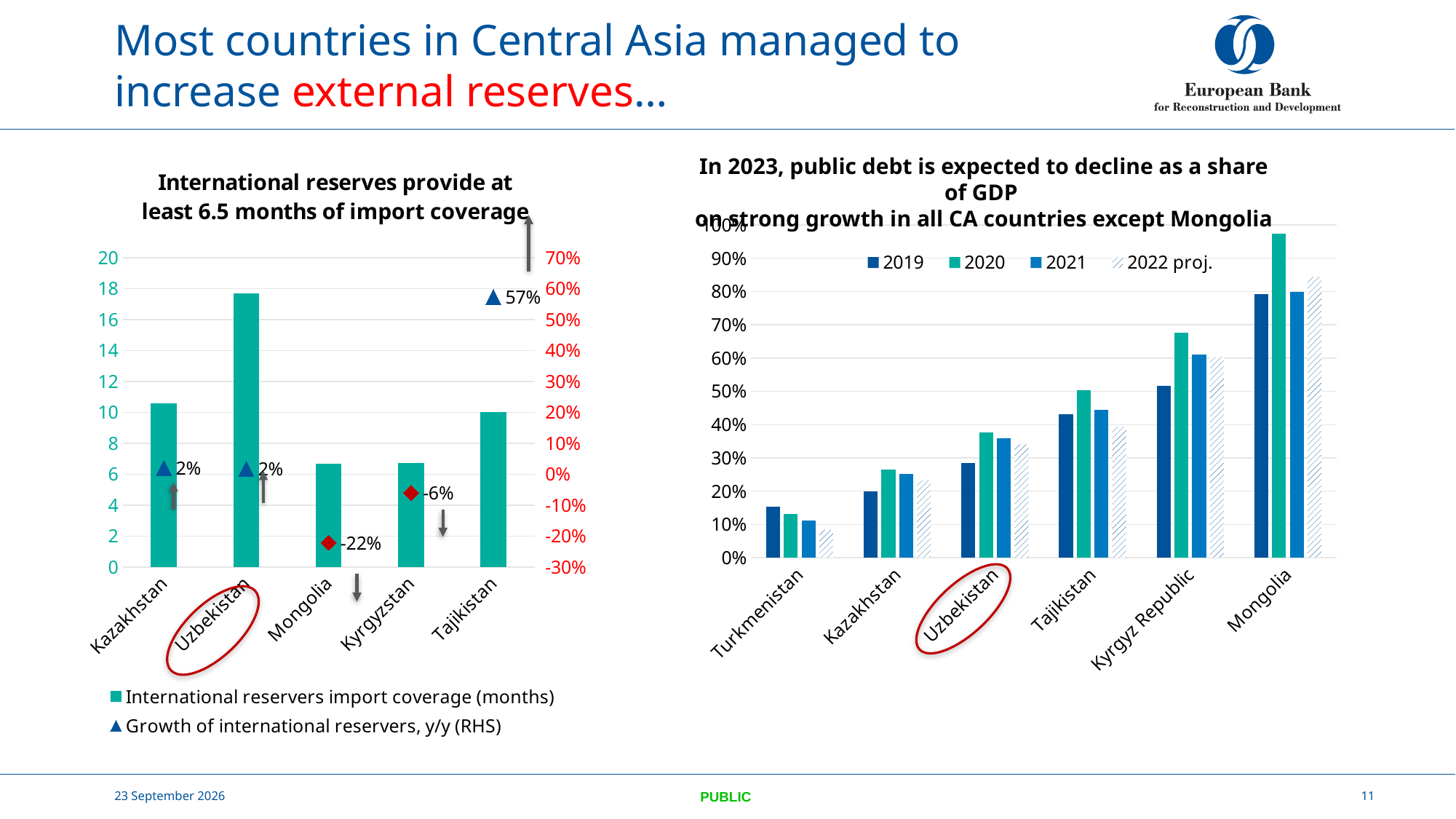
In the left chart, which country has the lowest growth of international reserves? Mongolia In the left chart, what is the growth of international reserves (y/y) for Tajikistan? 57% How many countries are shown on the x axis of the right chart (public debt as a share of GDP)? 6 In the left chart, what is the growth of international reserves (y/y) for Mongolia? -22% In the left chart, what is the growth of international reserves (y/y) for Kyrgyzstan? -6% In the right chart (public debt as a share of GDP), is the 2020 value for Mongolia greater or less than 90%? greater In the right chart (public debt as a share of GDP), which country has the highest 2020 value? Mongolia How many series does the legend of the right chart (public debt as a share of GDP) list? 4 In the left chart, which country has the tallest bar for international reserves import coverage (months)? Uzbekistan In the left chart, is the import coverage bar for Uzbekistan greater or less than 16 months? greater In the left chart, which country has the highest growth of international reserves? Tajikistan How many series does the legend of the left chart list? 2